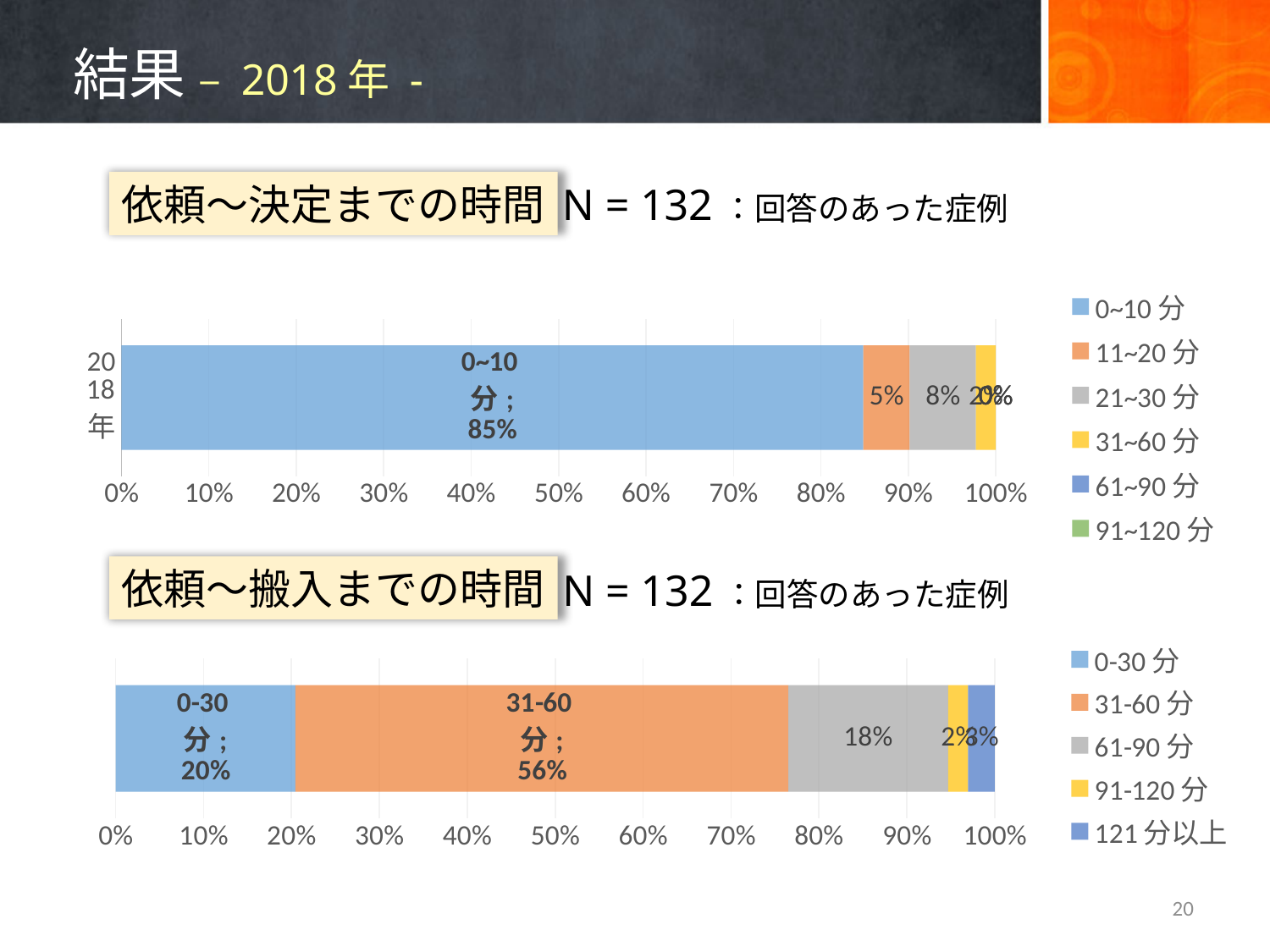
In the top chart (依頼～決定までの時間), what percentage is shown for the 11~20分 segment? 5% In the top chart (依頼～決定までの時間), what percentage is shown for the 21~30分 segment? 8% In the bottom chart (依頼～搬入までの時間), how many entries does the legend list? 5 In the bottom chart (依頼～搬入までの時間), which category has the largest share? 31-60分 In the bottom chart (依頼～搬入までの時間), what percentage is shown for the 0-30分 segment? 20% In the bottom chart (依頼～搬入までの時間), what percentage is shown for the 61-90分 segment? 18% In the top chart (依頼～決定までの時間), which category has the largest share? 0~10分 In the top chart (依頼～決定までの時間), how many entries does the legend list? 6 What type of chart is the top chart (依頼～決定までの時間)? Stacked bar chart In the top chart (依頼～決定までの時間), which is larger, the 11~20分 segment or the 21~30分 segment? 21~30分 In the bottom chart (依頼～搬入までの時間), what percentage is shown for the 31-60分 segment? 56% In the top chart (依頼～決定までの時間), what percentage is shown for the 0~10分 segment? 85%